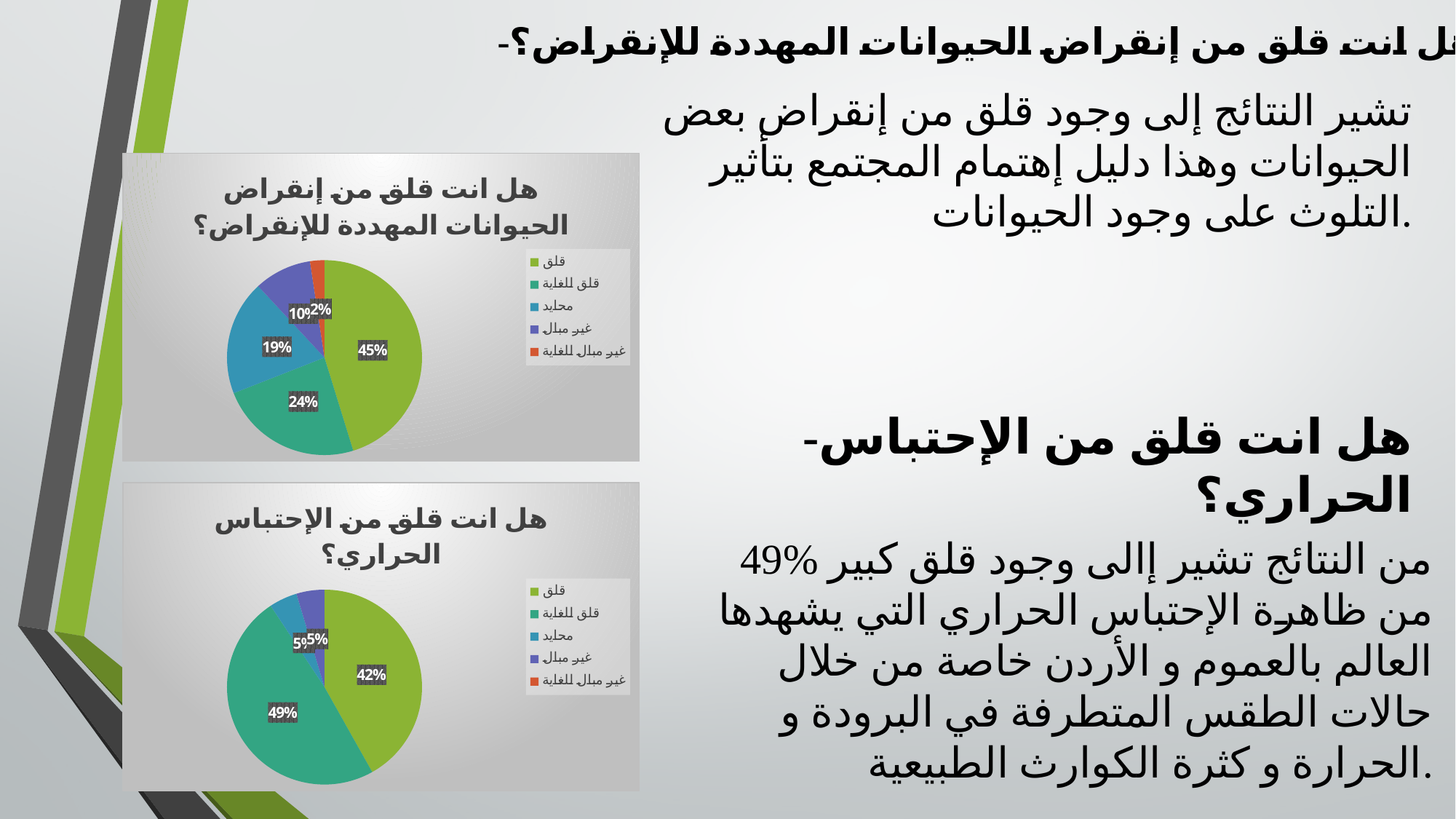
What kind of chart is the top chart on the slide? pie chart In the top pie chart (هل انت قلق من إنقراض الحيوانات المهددة للإنقراض؟), what share does the قلق slice have? 45% In the bottom pie chart (هل انت قلق من الإحتباس الحراري؟), what share does the قلق للغاية slice have? 49% In the bottom pie chart (هل انت قلق من الإحتباس الحراري؟), what share does the قلق slice have? 42% In the bottom pie chart (هل انت قلق من الإحتباس الحراري؟), which is larger, the قلق slice or the قلق للغاية slice? قلق للغاية In the top pie chart (هل انت قلق من إنقراض الحيوانات المهددة للإنقراض؟), which category has the smallest share? غير مبال للغاية In the bottom pie chart (هل انت قلق من الإحتباس الحراري؟), what is the difference between the قلق للغاية share and the محايد share? 44% What is the title of the bottom pie chart? هل انت قلق من الإحتباس الحراري؟ How many entries does the legend of the top pie chart list? 5 In the top pie chart (هل انت قلق من إنقراض الحيوانات المهددة للإنقراض؟), what share does the محايد slice have? 19% In the top pie chart (هل انت قلق من إنقراض الحيوانات المهددة للإنقراض؟), what is the difference between the قلق للغاية share and the غير مبال share? 14% In the top pie chart (هل انت قلق من إنقراض الحيوانات المهددة للإنقراض؟), which category has the largest share? قلق